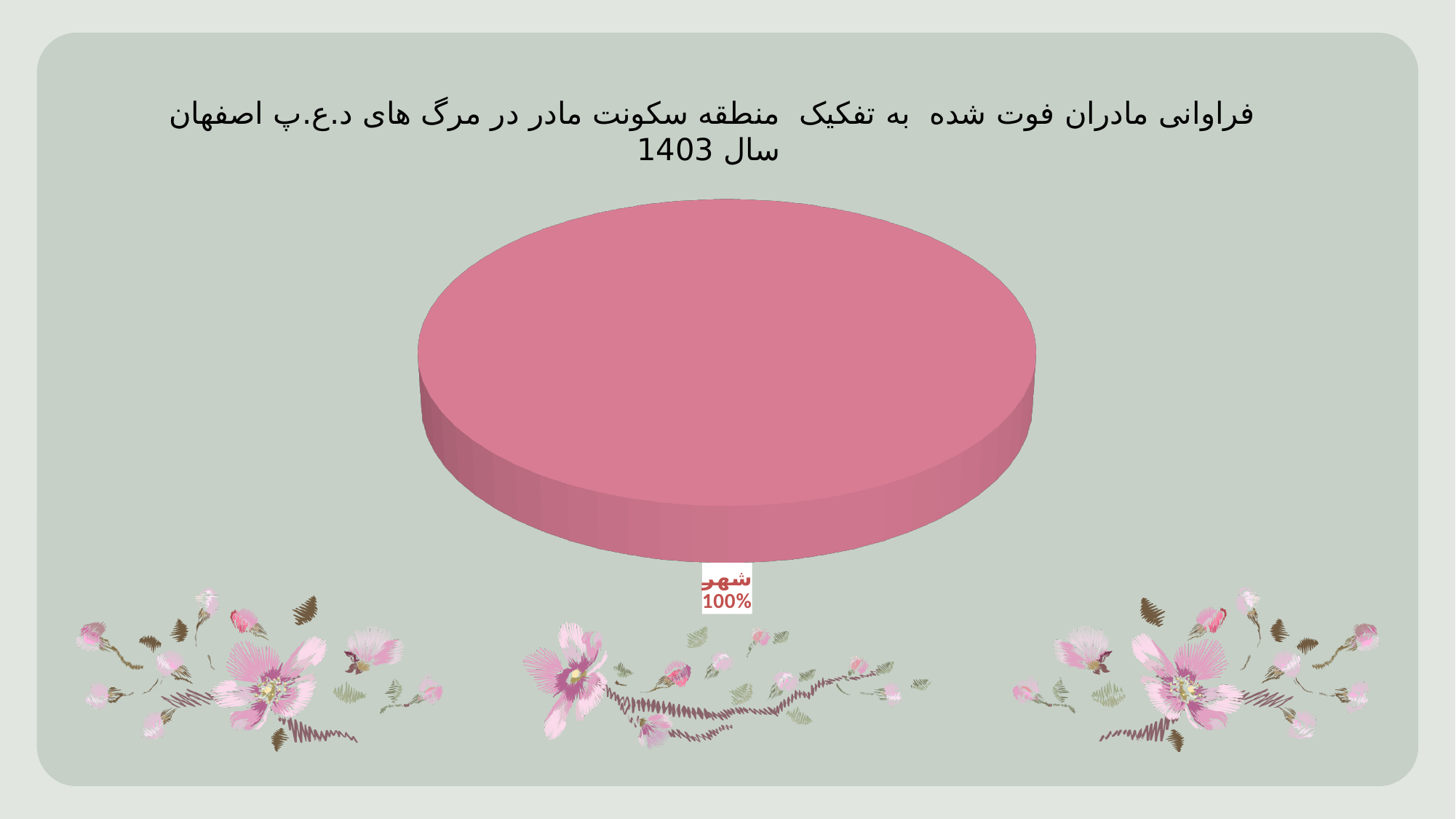
What kind of chart is shown on the slide? pie chart What is the label of the only slice in the pie chart? شهر What percentage is shown for the slice labelled شهر? 100% How many slices does the pie chart have? 1 What share of the pie does the شهر slice take up? 100% Which year is mentioned in the chart title? 1403